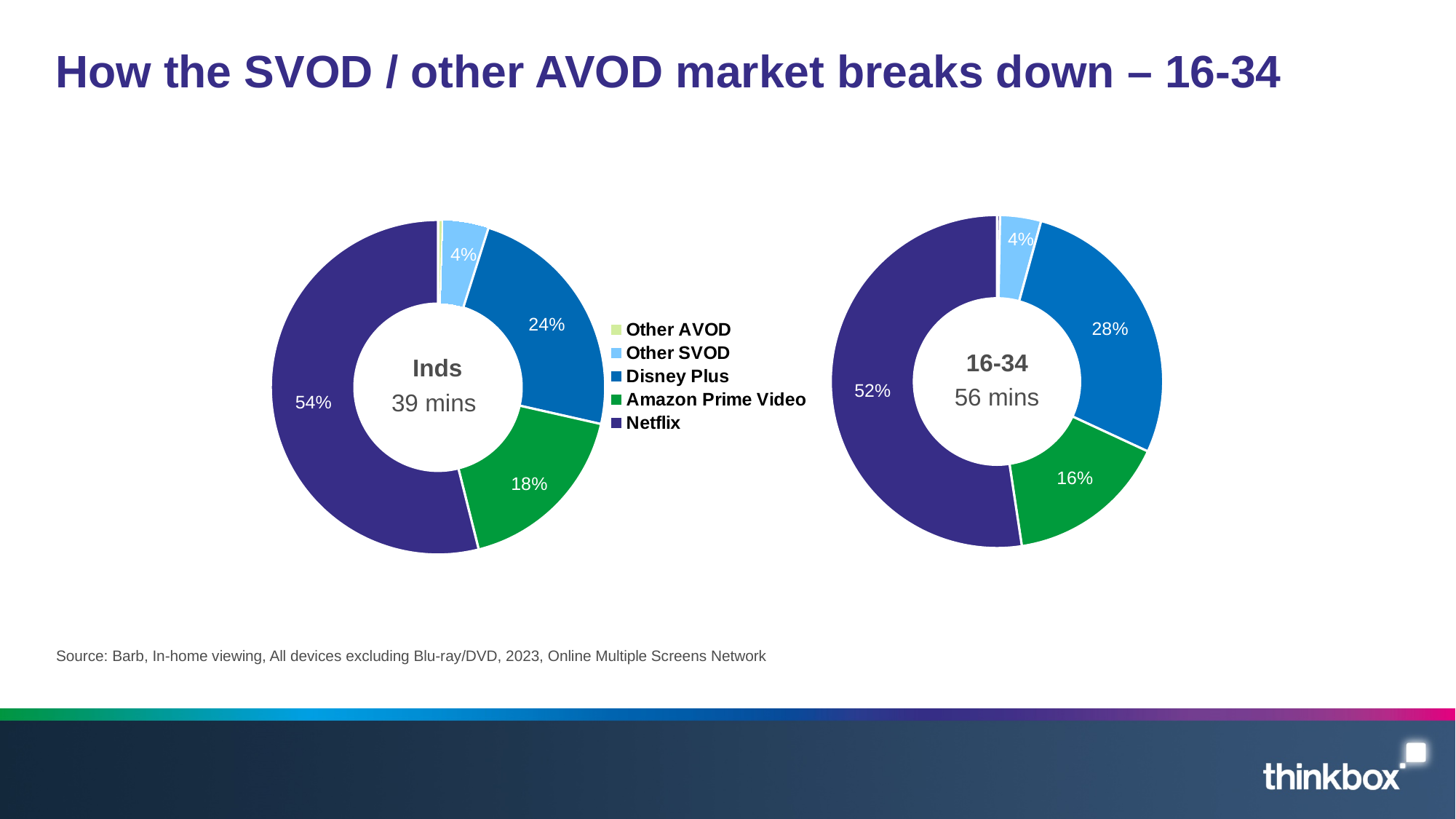
In the 16-34 chart, what share does Disney Plus have? 28% What kind of chart is used on this slide? Pie (donut) chart In the Inds chart, which category has the largest share? Netflix What viewing time is shown in the centre of the 16-34 chart? 56 mins In the Inds chart, is the Disney Plus share larger than the Amazon Prime Video share? Yes In the Inds chart, what share does Netflix have? 54% What is the difference between the Disney Plus share in the 16-34 chart and in the Inds chart? 4 percentage points In the Inds chart, what share does Other SVOD have? 4% In the 16-34 chart, which category has the largest share? Netflix How many categories does the legend list? 5 In the 16-34 chart, what share does Amazon Prime Video have? 16% Is the Netflix share larger in the Inds chart or in the 16-34 chart? Inds